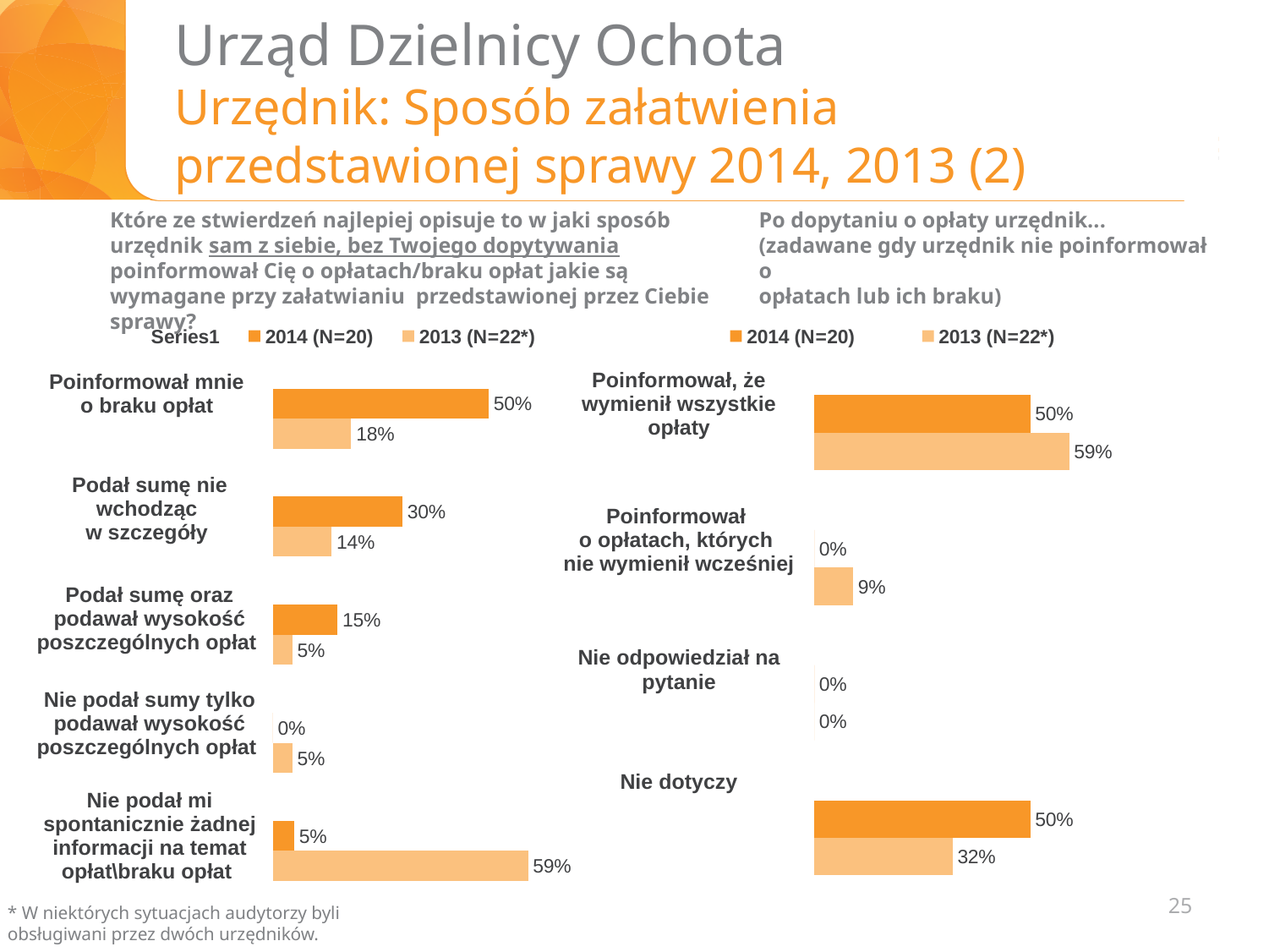
In the right chart, what is the difference between the 2013 and 2014 values for "Poinformował o opłatach, których nie wymienił wcześniej"? 9 percentage points What type of chart is the right chart? Bar chart In the left chart, how many entries does the legend list? 3 In the left chart, what is the 2013 (N=22*) value for "Nie podał mi spontanicznie żadnej informacji na temat opłat\braku opłat"? 59% In the left chart, which category has the highest 2013 (N=22*) value? Nie podał mi spontanicznie żadnej informacji na temat opłat\braku opłat In the left chart, what is the difference between the 2014 and 2013 values for "Podał sumę nie wchodząc w szczegóły"? 16 percentage points In the left chart, what is the 2014 (N=20) value for "Poinformował mnie o braku opłat"? 50% In the right chart, what is the 2013 (N=22*) value for "Poinformował, że wymienił wszystkie opłaty"? 59% In the right chart, what is the 2014 (N=20) value for "Nie dotyczy"? 50% In the right chart, which is larger for "Nie dotyczy": the 2014 value or the 2013 value? 2014 (N=20) In the left chart, how many categories are shown? 5 In the right chart, how many categories are shown? 4